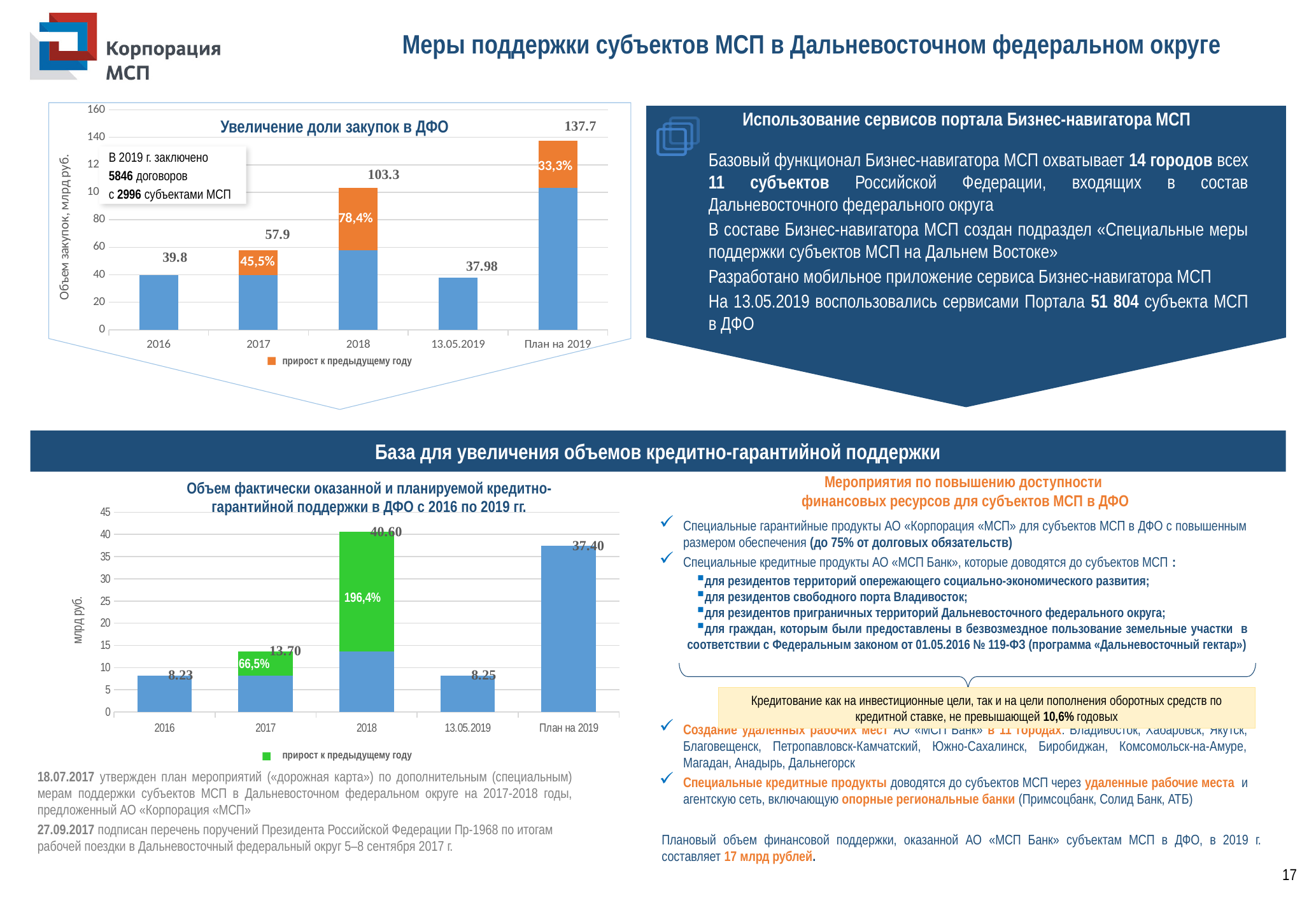
In the chart 'Увеличение доли закупок в ДФО', how many categories are shown on the x axis? 5 In the chart 'Объем фактически оказанной и планируемой кредитно-гарантийной поддержки в ДФО с 2016 по 2019 гг.', which category has the lowest value? 2016 In the chart 'Увеличение доли закупок в ДФО', what is the difference between the values for 2018 and 2017? 45.4 In the chart 'Увеличение доли закупок в ДФО', what is the value for 'План на 2019'? 137.7 In the chart 'Объем фактически оказанной и планируемой кредитно-гарантийной поддержки в ДФО с 2016 по 2019 гг.', what is the value for 2018? 40.60 In the chart 'Увеличение доли закупок в ДФО', which category has the highest value? План на 2019 In the chart 'Увеличение доли закупок в ДФО', what is the value for 2016? 39.8 In the chart 'Объем фактически оказанной и планируемой кредитно-гарантийной поддержки в ДФО с 2016 по 2019 гг.', what is the difference between the values for 2017 and 2016? 5.47 In the chart 'Объем фактически оказанной и планируемой кредитно-гарантийной поддержки в ДФО с 2016 по 2019 гг.', which is larger: the value for 2018 or the value for 'План на 2019'? 2018 In the chart 'Увеличение доли закупок в ДФО', what is the y-axis label? Объем закупок, млрд руб. In the chart 'Увеличение доли закупок в ДФО', what percentage growth is shown on the 2018 bar? 78,4% What type of chart is 'Объем фактически оказанной и планируемой кредитно-гарантийной поддержки в ДФО с 2016 по 2019 гг.'? Bar chart